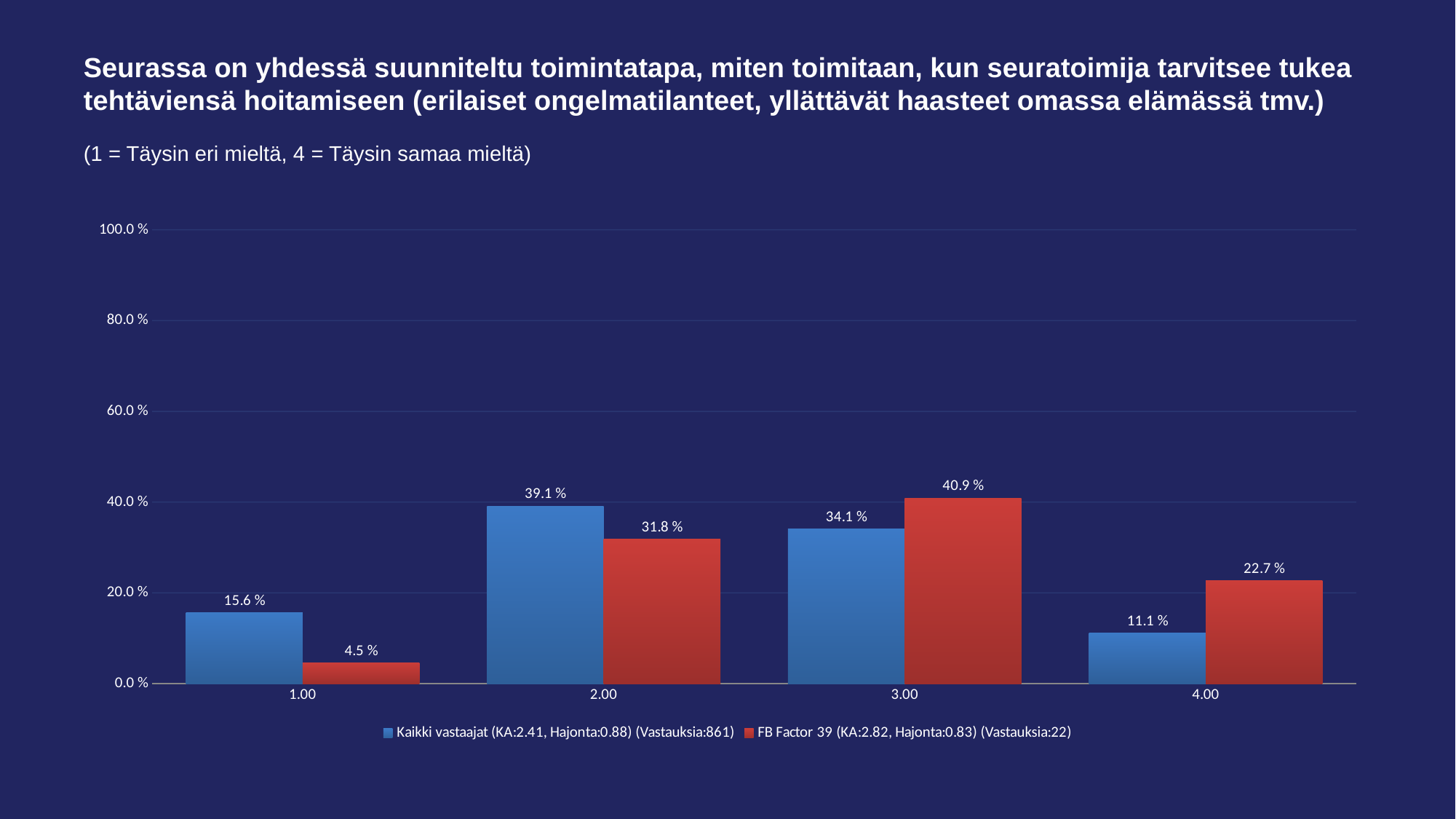
What is the value for FB Factor 39 at 4.00? 22.7 % Which category has the highest value for FB Factor 39? 3.00 What is the value for FB Factor 39 at 1.00? 4.5 % Which category has the lowest value for Kaikki vastaajat? 4.00 What colour are the bars for the FB Factor 39 series? red What kind of chart is shown on the slide? bar chart How many series does the legend list? 2 How many categories are shown on the x axis? 4 Is the value for Kaikki vastaajat at 1.00 greater or less than 20.0 %? less Which series has the larger value at 3.00, Kaikki vastaajat or FB Factor 39? FB Factor 39 What is the difference between the Kaikki vastaajat and FB Factor 39 values at 2.00? 7.3 % What is the value for Kaikki vastaajat at 2.00? 39.1 %